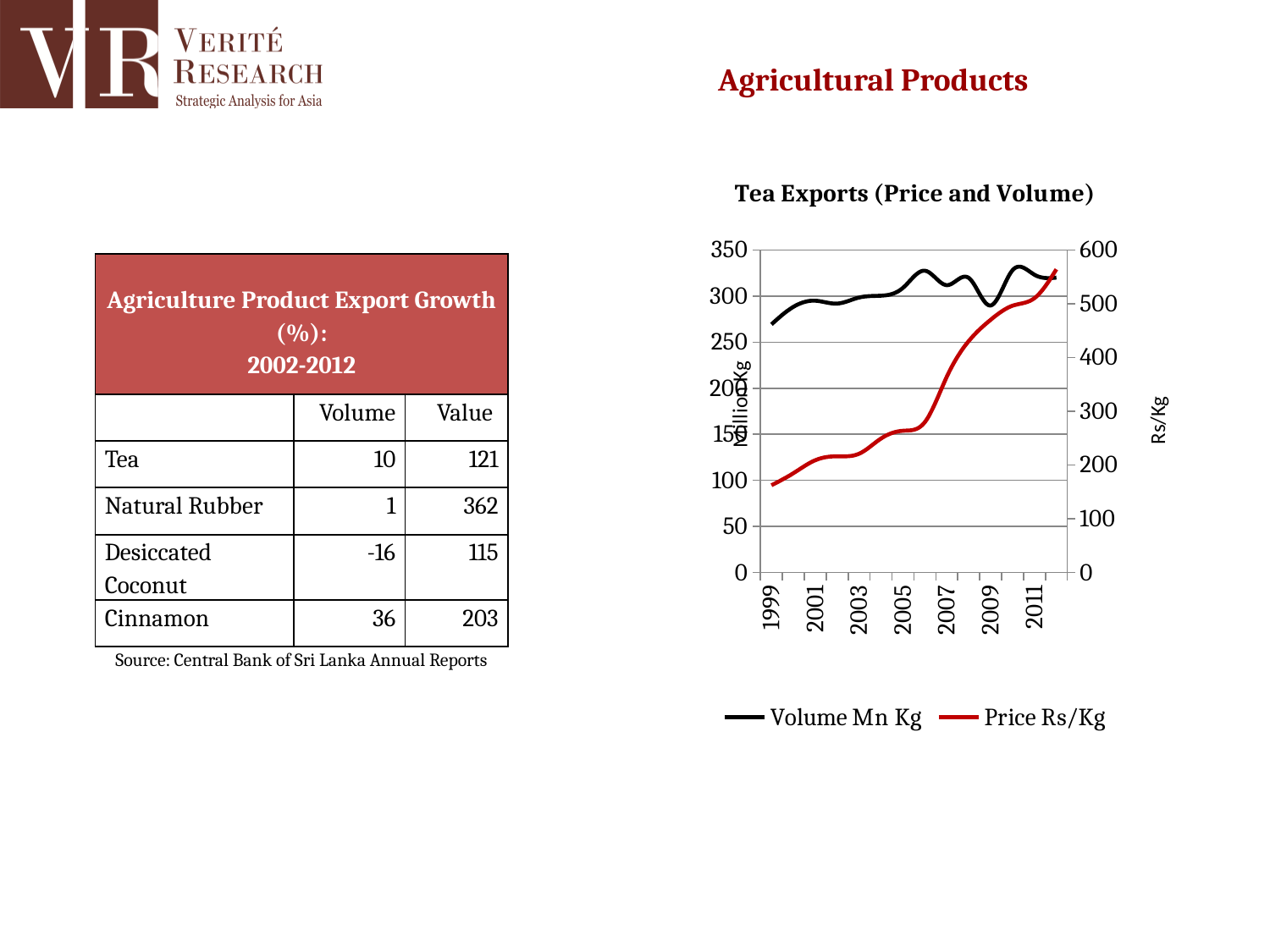
In the 'Tea Exports (Price and Volume)' chart, is the Price Rs/Kg value in 1999 greater or less than 200? less In the 'Tea Exports (Price and Volume)' chart, is the Volume Mn Kg value in 2011 greater or less than 300? greater In the 'Tea Exports (Price and Volume)' chart, what colour is the Price Rs/Kg line? red In the 'Tea Exports (Price and Volume)' chart, is the Price Rs/Kg value higher in 2009 or in 2003? 2009 How many year labels are shown on the x axis of the 'Tea Exports (Price and Volume)' chart? 7 In the 'Tea Exports (Price and Volume)' chart, is the Volume Mn Kg value in 1999 greater or less than 300? less What kind of chart is 'Tea Exports (Price and Volume)'? line chart How many series does the legend of the 'Tea Exports (Price and Volume)' chart list? 2 In the 'Tea Exports (Price and Volume)' chart, in which year is the Price Rs/Kg line at its lowest? 1999 What are the two series named in the legend of the 'Tea Exports (Price and Volume)' chart? Volume Mn Kg and Price Rs/Kg In the 'Tea Exports (Price and Volume)' chart, does the Price Rs/Kg line rise or fall from 1999 to 2011? rise